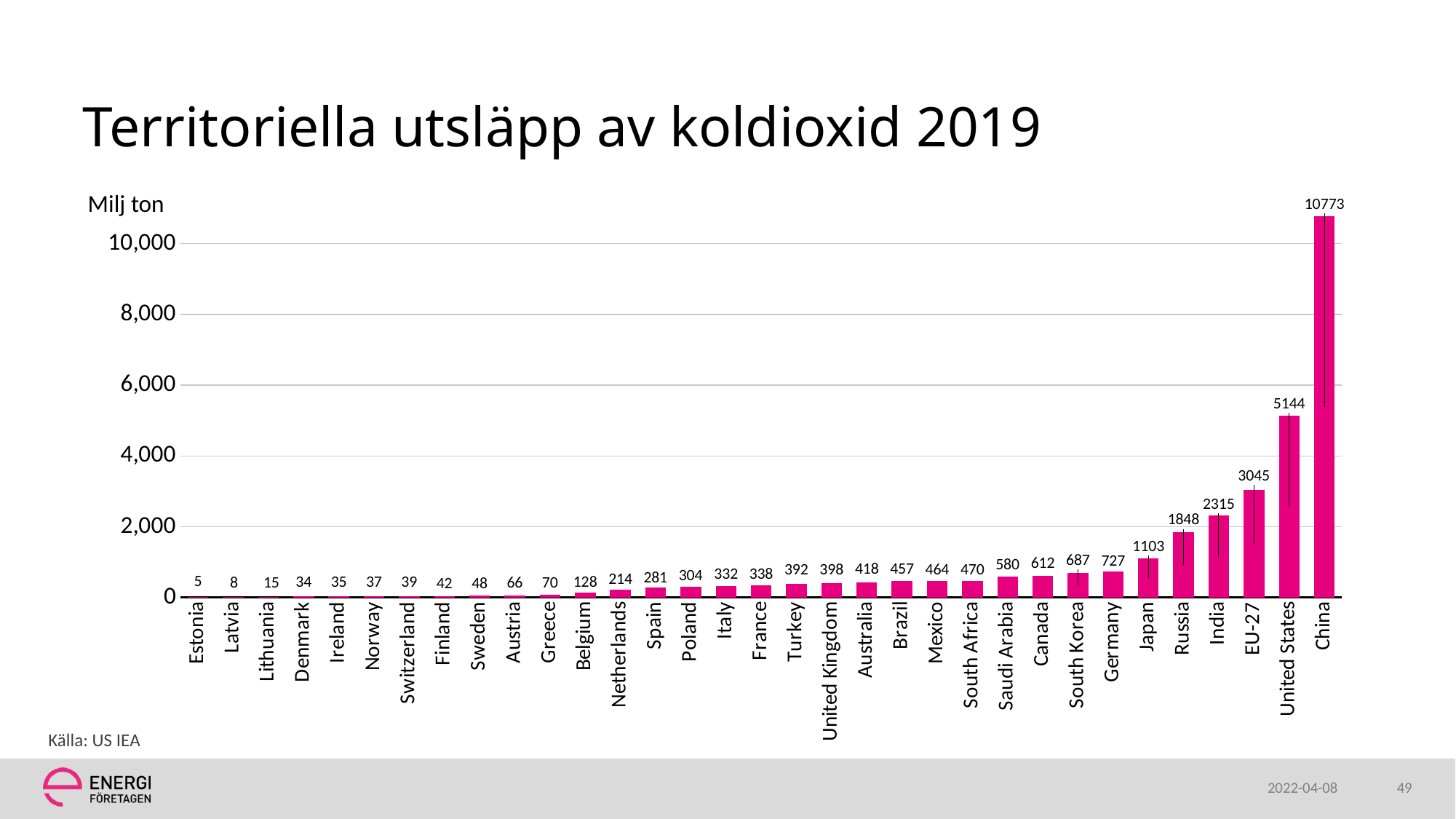
What is the value for Sweden? 48 Which country has the highest value? China What is the difference between the values for Japan and Germany? 376 What unit is shown above the y axis? Milj ton What is the value for Germany? 727 Which country has the lowest value? Estonia How many countries or regions are shown on the x axis? 33 What is the difference between the values for China and the United States? 5629 What kind of chart is shown? Bar chart Which is larger, the value for India or the value for Russia? India What is the value for China? 10773 What is the value for EU-27? 3045